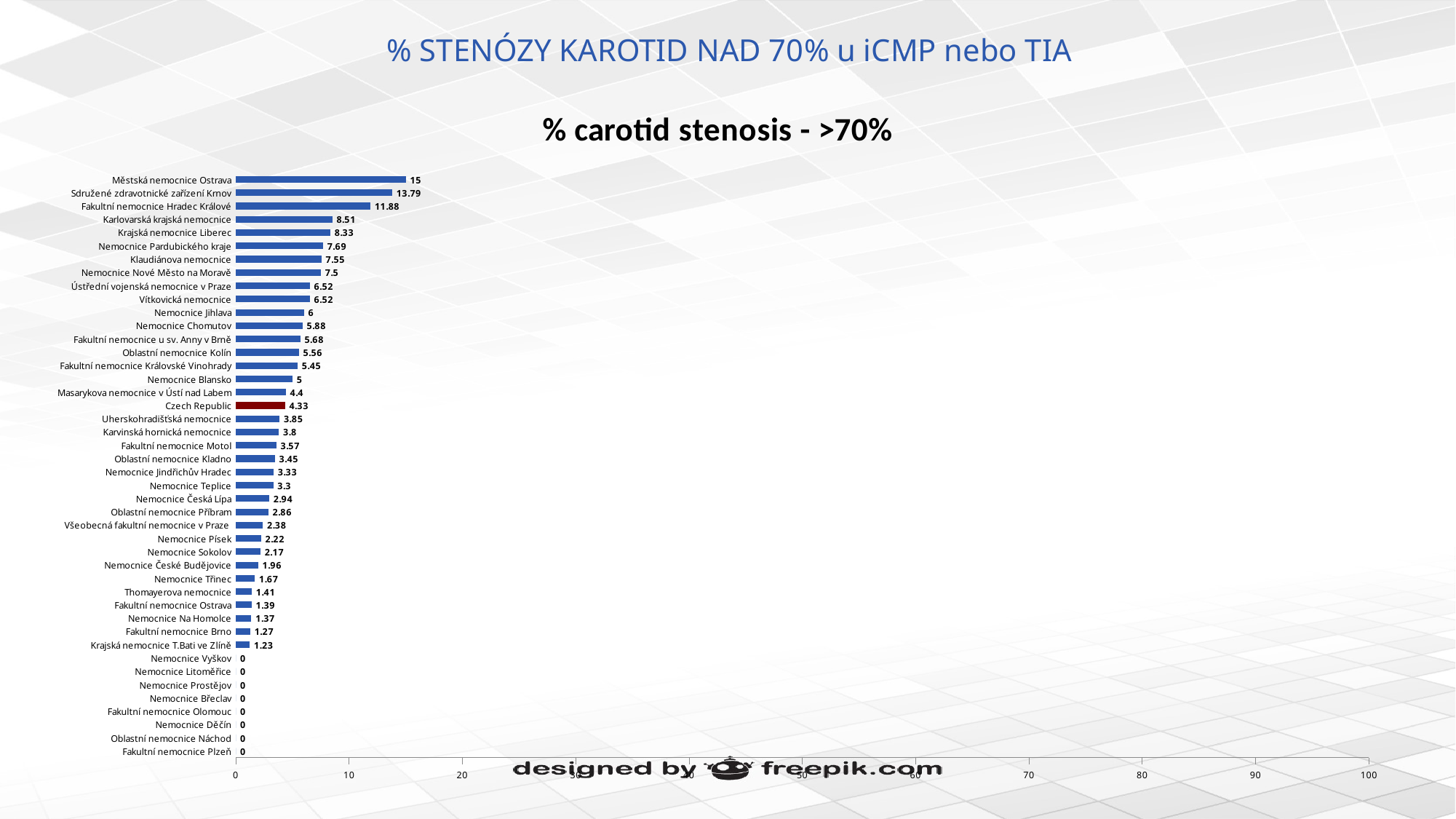
Which is larger, the value for Karlovarská krajská nemocnice or the value for Nemocnice Jihlava? Karlovarská krajská nemocnice What is the value for Městská nemocnice Ostrava? 15 Which hospital has the highest value? Městská nemocnice Ostrava What kind of chart is shown? bar chart What is the difference between the values for Sdružené zdravotnické zařízení Krnov and Fakultní nemocnice Hradec Králové? 1.91 What is the value for Fakultní nemocnice Motol? 3.57 How many hospitals have a value of 0? 8 Is the value for Fakultní nemocnice Hradec Králové greater or less than 10? greater What is the title of the chart? % carotid stenosis - >70% What is the difference between the values for Czech Republic and Masarykova nemocnice v Ústí nad Labem? 0.07 What is the value for Czech Republic? 4.33 Which bar is coloured dark red instead of blue? Czech Republic